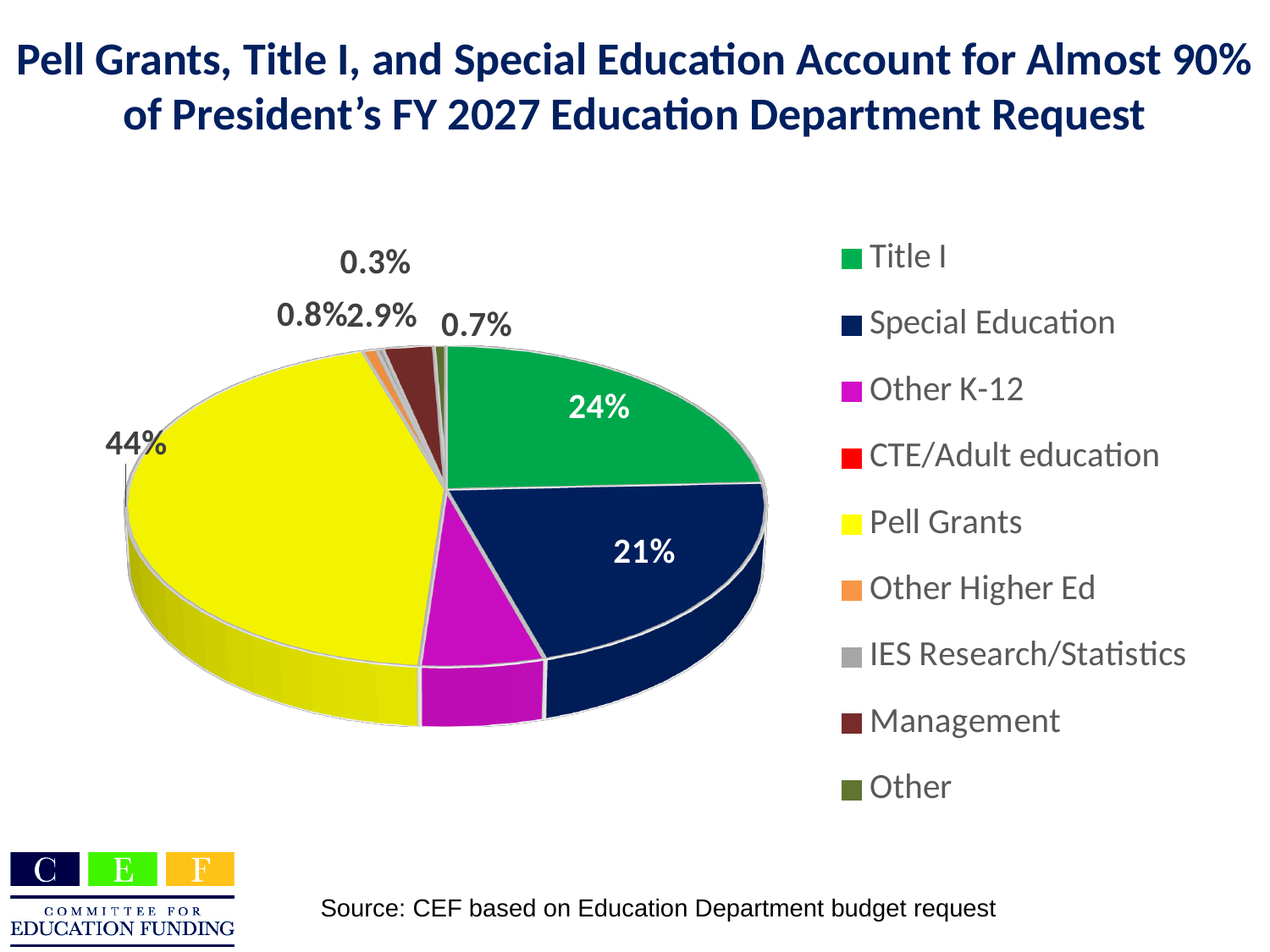
How many percentage points larger is the Title I share than the Special Education share? 3 percentage points According to the slide title, what fiscal year's Education Department request does the chart show? FY 2027 What share of the request do Pell Grants account for? 44% How many percentage points larger is the Pell Grants share than the Title I share? 20 percentage points What is the combined share of Pell Grants, Title I, and Special Education? 89% Which category has the largest slice of the pie? Pell Grants What colour represents Pell Grants in the pie chart? Yellow How many categories does the legend list? 9 Which is larger, the Title I slice or the Special Education slice? Title I What share of the request does Title I account for? 24% What kind of chart is shown on the slide? Pie chart What share of the request does Special Education account for? 21%